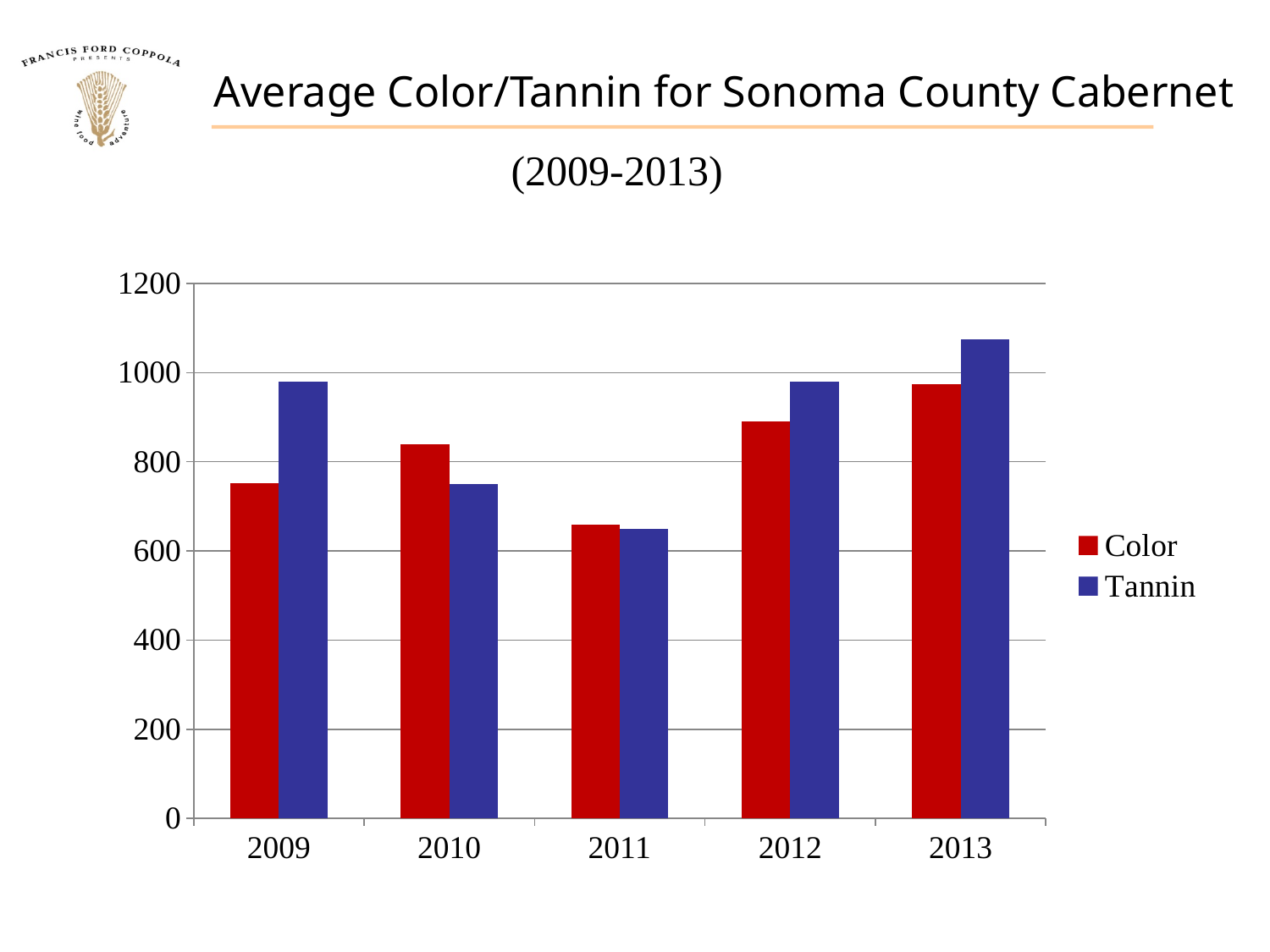
Which colour represents the Tannin series in the legend? blue How many years are shown on the x axis? 5 What kind of chart is shown on the slide? bar chart Is the Tannin value for 2013 greater or less than 1000? greater Which year has the lowest Tannin value? 2011 Which year has the highest Tannin value? 2013 Which year has the highest Color value? 2013 In 2010, which is larger, Color or Tannin? Color In 2009, which is larger, Color or Tannin? Tannin Which year has the lowest Color value? 2011 Is the Color value for 2011 greater or less than 800? less How many series does the legend list? 2